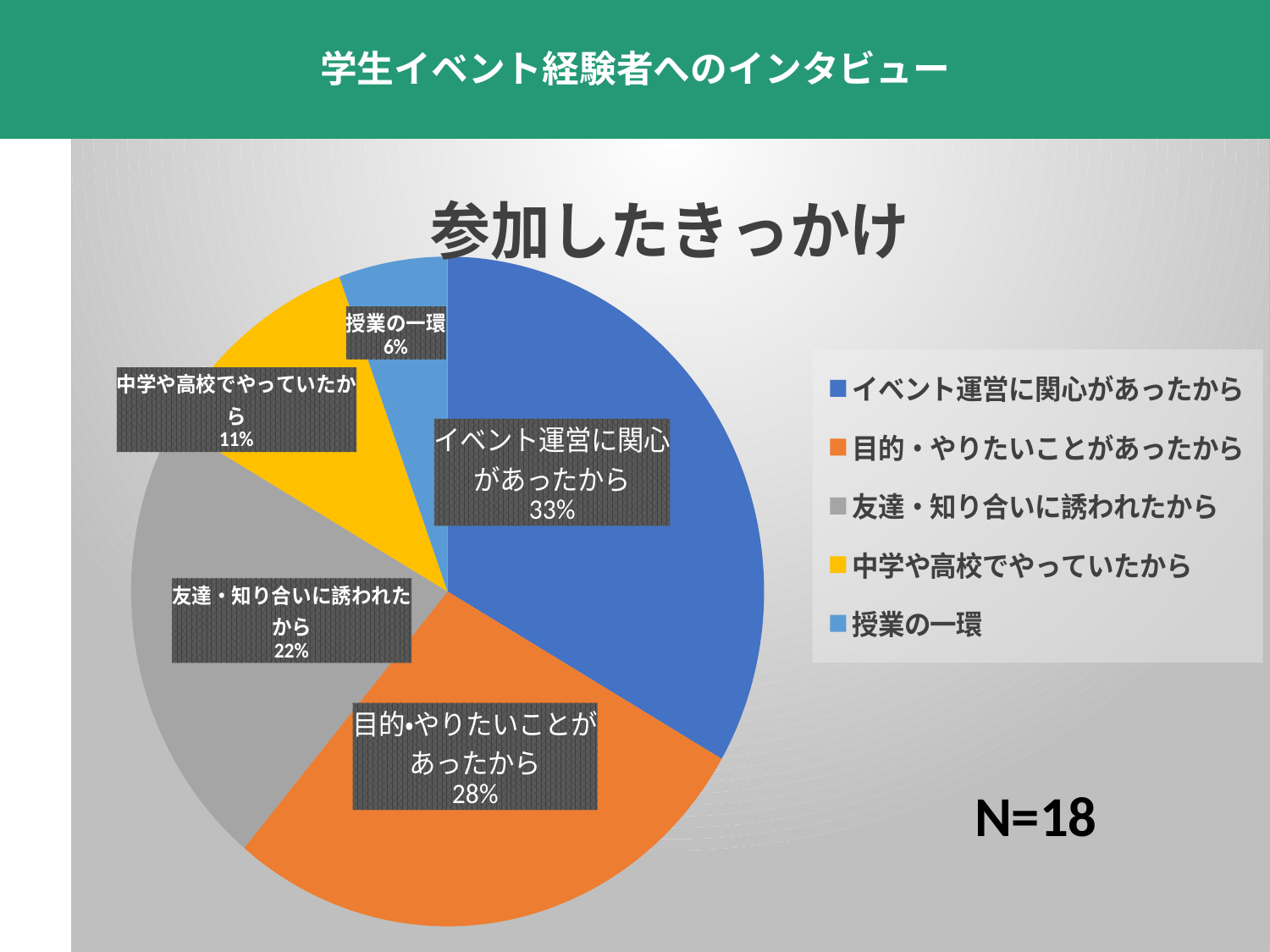
What share of the pie is 「友達・知り合いに誘われたから」? 22% What share of the pie is 「イベント運営に関心があったから」? 33% Which category has the largest share of the pie? イベント運営に関心があったから What kind of chart is shown on the slide? pie chart Which is larger, the share for 「友達・知り合いに誘われたから」 or the share for 「中学や高校でやっていたから」? 友達・知り合いに誘われたから What share of the pie is 「中学や高校でやっていたから」? 11% What is the difference in percentage points between 「イベント運営に関心があったから」 and 「目的・やりたいことがあったから」? 5 percentage points Which category has the smallest share of the pie? 授業の一環 How many categories does the pie chart have? 5 What is the title of the chart? 参加したきっかけ